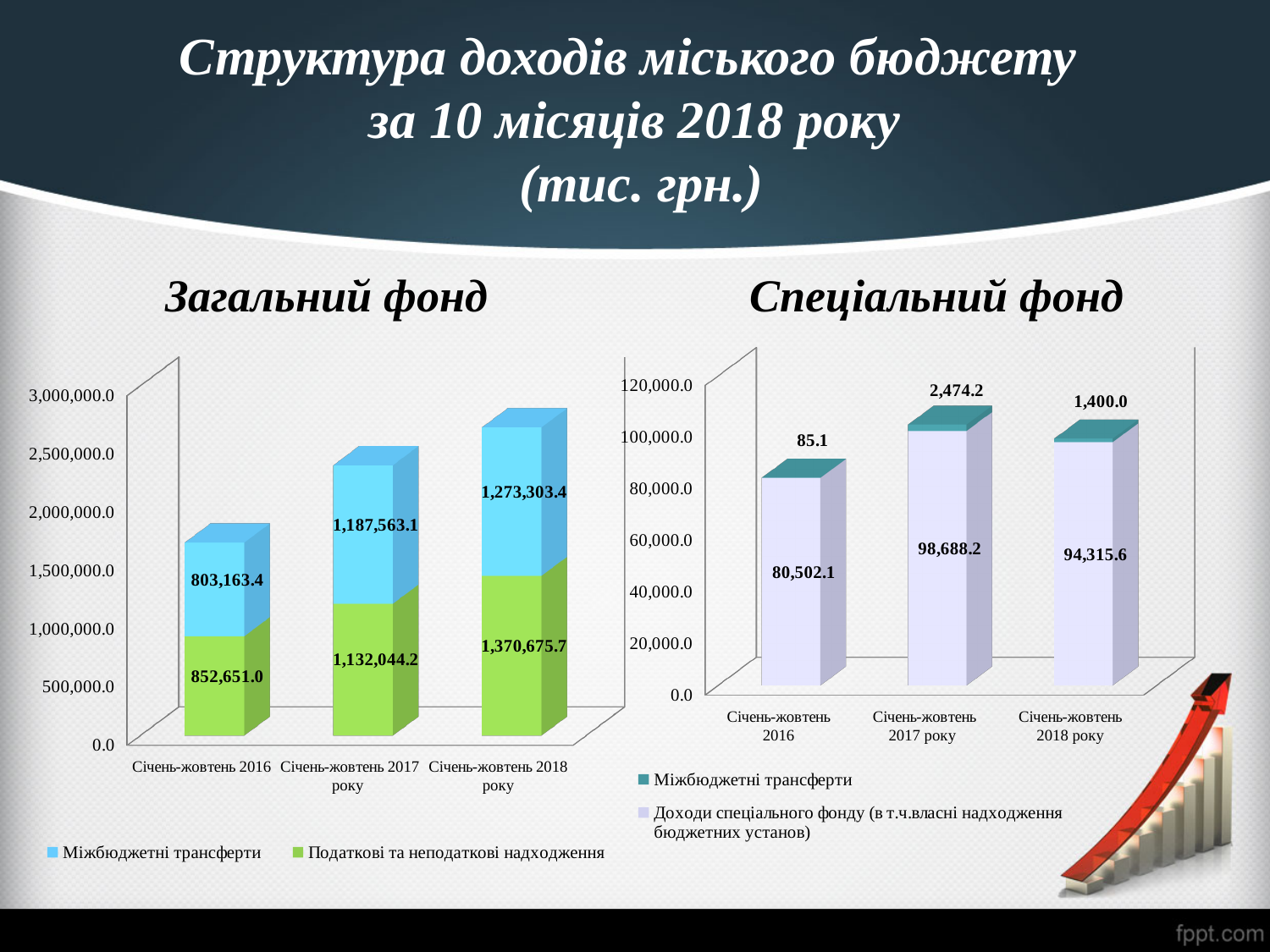
What kind of chart is the Спеціальний фонд chart? Stacked bar chart In the Спеціальний фонд chart, what is the value of Міжбюджетні трансферти for Січень-жовтень 2016? 85.1 In the Спеціальний фонд chart, which is larger: Доходи спеціального фонду for Січень-жовтень 2017 року or for Січень-жовтень 2018 року? Січень-жовтень 2017 року In the Загальний фонд chart, what is the value of Податкові та неподаткові надходження for Січень-жовтень 2018 року? 1,370,675.7 In the Спеціальний фонд chart, what is the value of Доходи спеціального фонду for Січень-жовтень 2018 року? 94,315.6 How many series does the legend of the Загальний фонд chart list? 2 In the Загальний фонд chart, what is the value of Міжбюджетні трансферти for Січень-жовтень 2017 року? 1,187,563.1 In the Спеціальний фонд chart, what is the total of the stacked bar for Січень-жовтень 2017 року? 101,162.4 In the Загальний фонд chart, which period has the highest value of Податкові та неподаткові надходження? Січень-жовтень 2018 року In the Загальний фонд chart, what is the total of the stacked bar for Січень-жовтень 2016? 1,655,814.4 In the Спеціальний фонд chart, which period has the lowest value of Міжбюджетні трансферти? Січень-жовтень 2016 In the Загальний фонд chart, what is the difference between Податкові та неподаткові надходження for Січень-жовтень 2018 року and Січень-жовтень 2017 року? 238,631.5